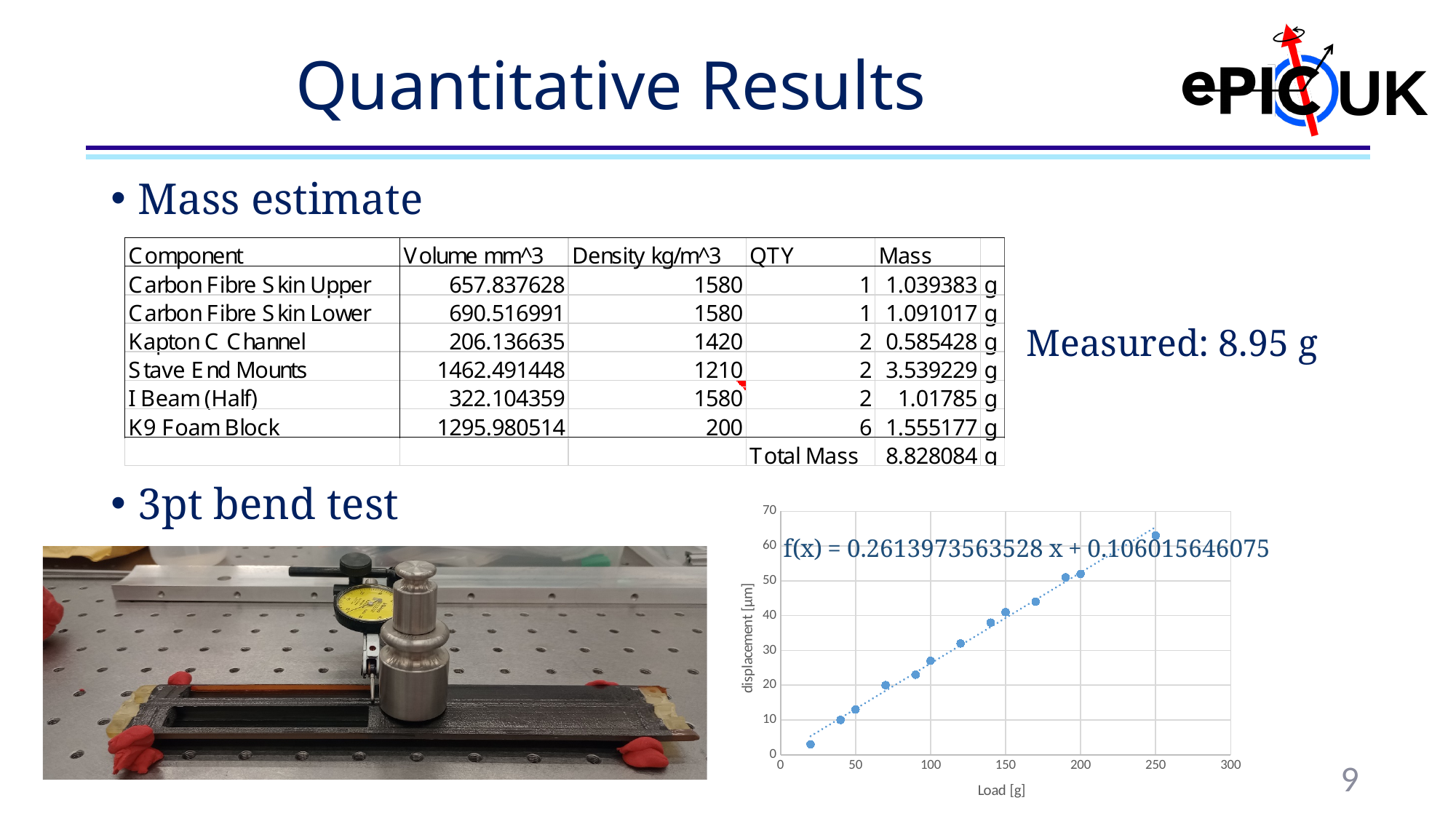
What kind of chart is shown in the 3pt bend test section? scatter chart In the 3pt bend test chart, is the displacement at a load of 170 g greater or less than 50? less In the 3pt bend test chart, is the displacement at a load of 100 g greater or less than 30? less In the 3pt bend test chart, is the displacement at a load of 20 g greater or less than 10? less In the 3pt bend test chart, at which load is the displacement highest? 250 g What is the fitted trendline equation shown on the 3pt bend test chart? f(x) = 0.2613973563528 x + 0.106015646075 In the 3pt bend test chart, does displacement rise or fall as load increases? rise What is the label of the y axis in the 3pt bend test chart? displacement [µm] In the 3pt bend test chart, which has the larger displacement: a load of 250 g or a load of 100 g? 250 g